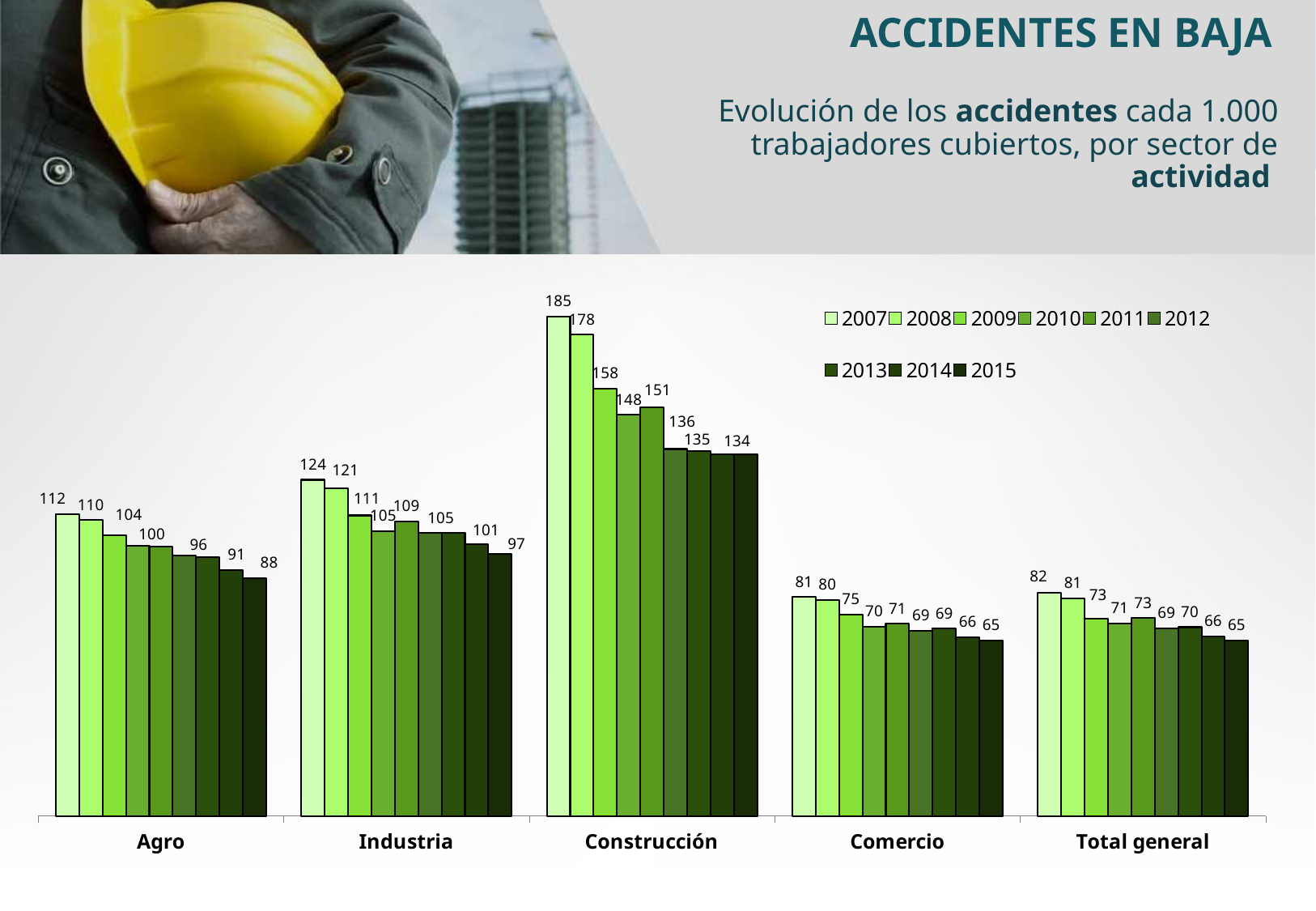
Do the values for Comercio generally rise or fall from 2007 to 2015? fall What is the value for Comercio in 2010? 70 How many series (years) does the legend list? 9 What is the value for Total general in 2015? 65 How many sector categories are shown on the x axis? 5 What is the difference between the 2007 values for Construcción and Agro? 73 Which is larger, the 2007 value for Industria or the 2007 value for Agro? Industria Which category has the highest value in 2007? Construcción What kind of chart is shown on the slide? bar chart Which category has the lowest value in 2007? Comercio What is the value for Agro in 2007? 112 What is the value for Construcción in 2007? 185